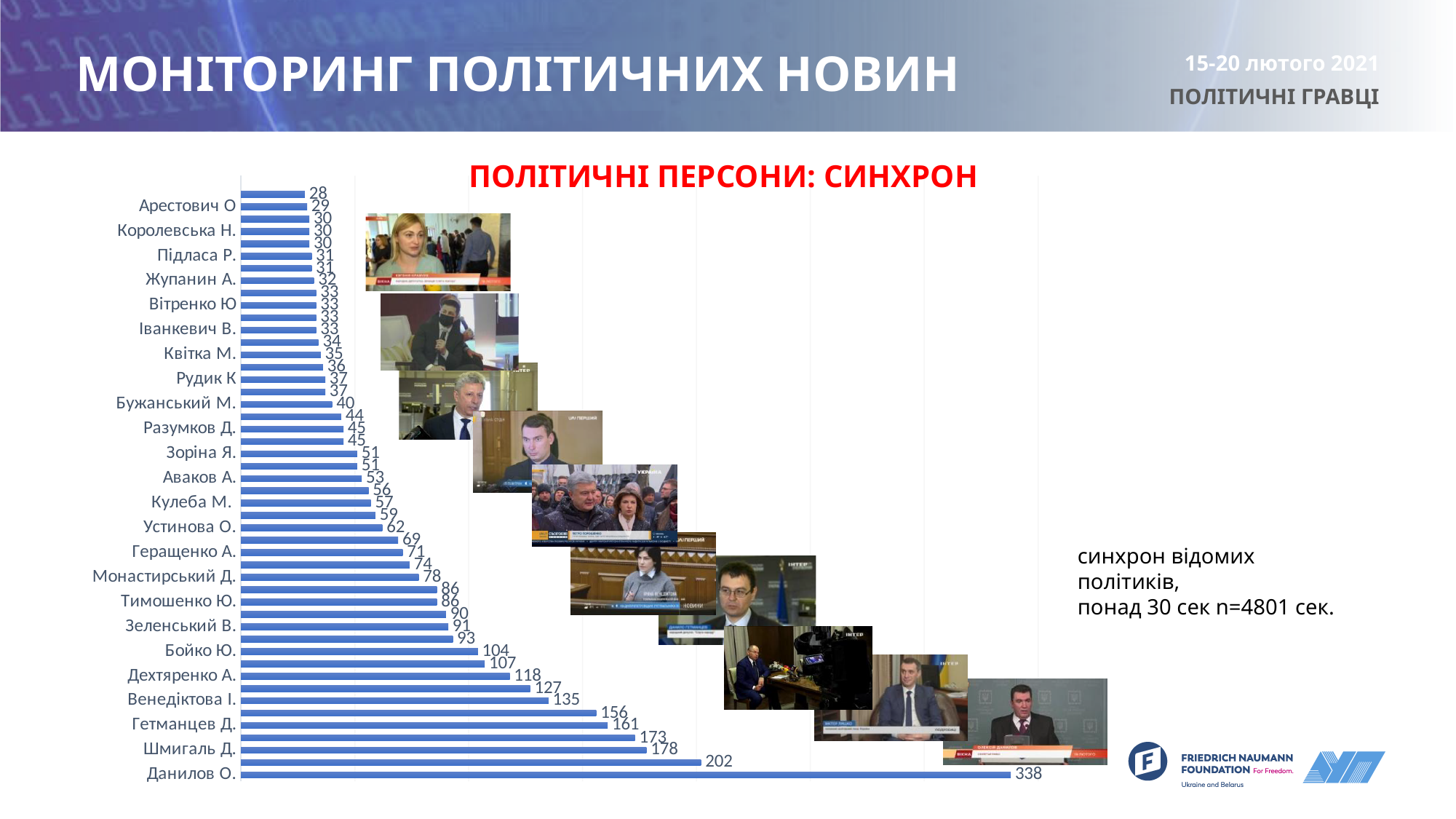
What is the value for Тимошенко Ю.? 86 What is the title of the chart? ПОЛІТИЧНІ ПЕРСОНИ: СИНХРОН What kind of chart is shown on the slide? Bar chart What is the value for Аваков А.? 53 What is the value for Данилов О.? 338 Which is larger, the value for Кулеба М. or the value for Разумков Д.? Кулеба М. What is the difference between the values for Данилов О. and Шмигаль Д.? 160 What is the value for Зеленський В.? 91 What is the value for Шмигаль Д.? 178 Which politician has the highest value in the chart? Данилов О. Which is larger, the value for Гетманцев Д. or the value for Венедіктова І.? Гетманцев Д. What is the difference between the values for Бойко Ю. and Зеленський В.? 13